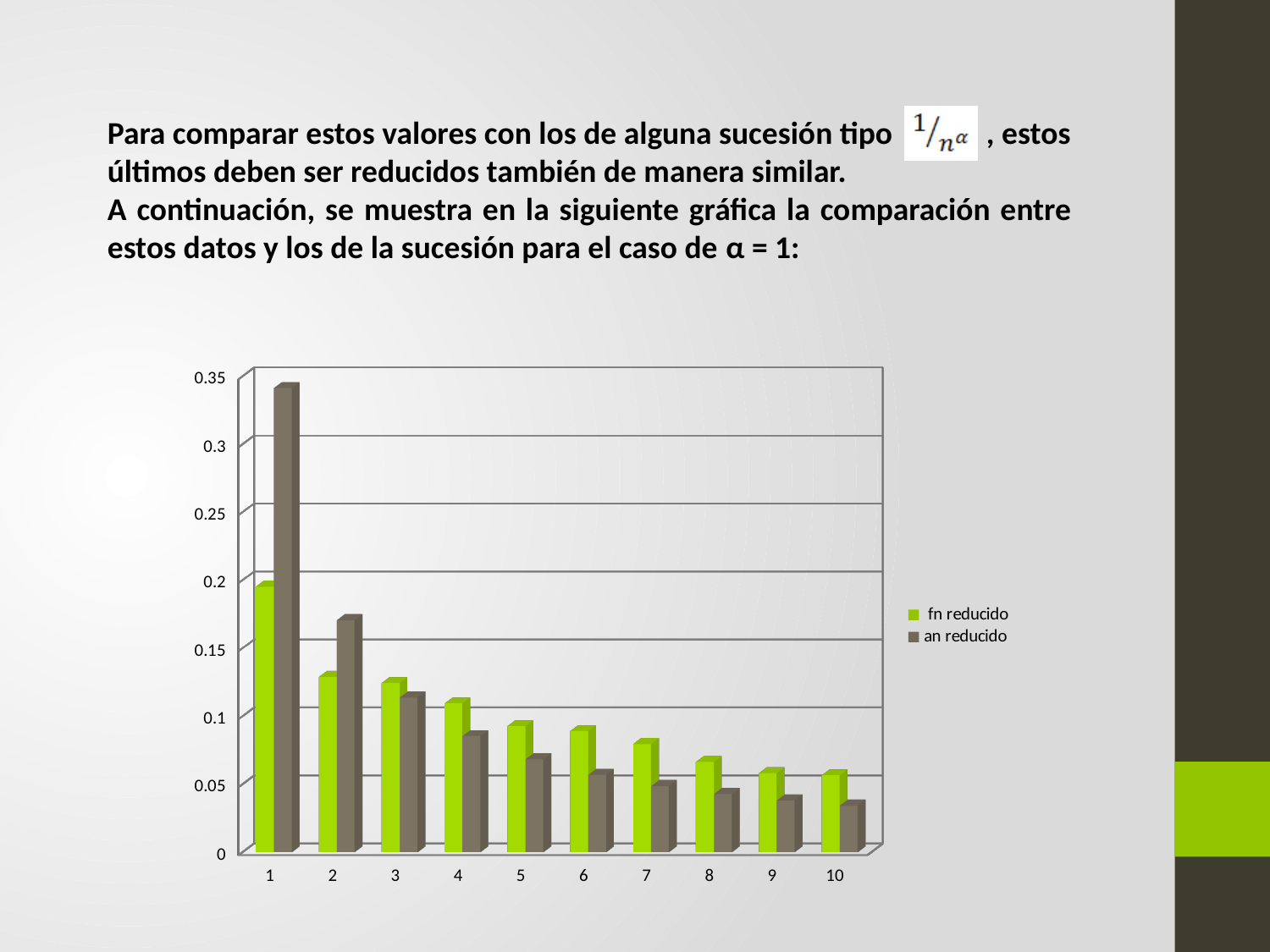
How many categories are shown on the x axis? 10 At category 4, which series has the larger value, fn reducido or an reducido? fn reducido Is the value of an reducido at category 1 greater or less than 0.3? greater For which category is the value of an reducido highest? 1 For which category is the value of an reducido lowest? 10 For which category is the value of fn reducido highest? 1 Do the values of fn reducido rise or fall from category 1 to category 10? fall Is the value of an reducido at category 10 greater or less than 0.05? less Which colour represents the fn reducido series in the legend? green How many series does the legend list? 2 What kind of chart is shown on the slide? bar chart At category 1, which series has the larger value, fn reducido or an reducido? an reducido